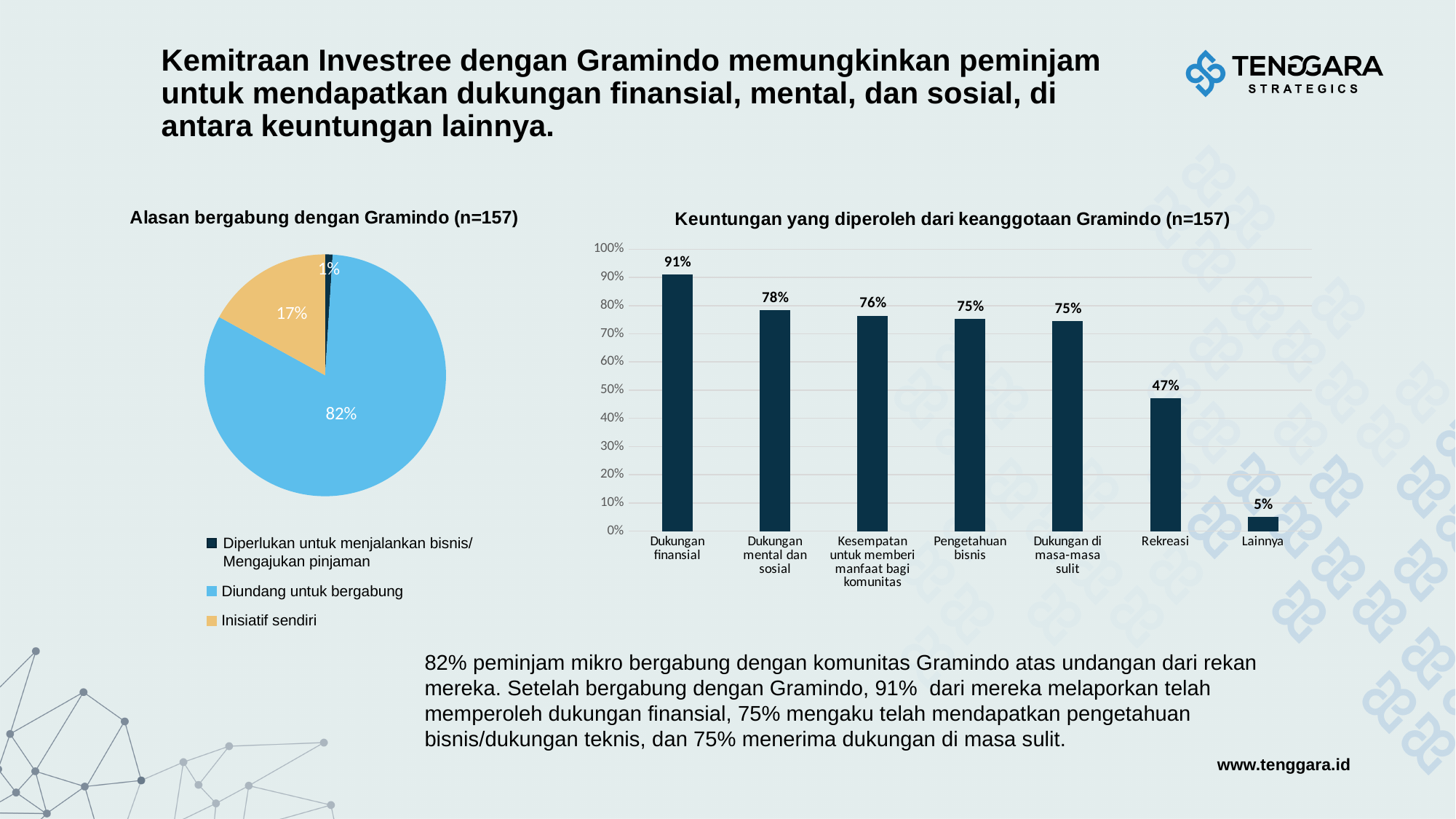
What kind of chart is 'Keuntungan yang diperoleh dari keanggotaan Gramindo (n=157)'? Bar chart In the pie chart 'Alasan bergabung dengan Gramindo (n=157)', which category has the smallest slice? Diperlukan untuk menjalankan bisnis/Mengajukan pinjaman In the bar chart 'Keuntungan yang diperoleh dari keanggotaan Gramindo (n=157)', which is larger: 'Kesempatan untuk memberi manfaat bagi komunitas' or 'Rekreasi'? Kesempatan untuk memberi manfaat bagi komunitas How many categories does the legend of the pie chart 'Alasan bergabung dengan Gramindo (n=157)' list? 3 In the bar chart 'Keuntungan yang diperoleh dari keanggotaan Gramindo (n=157)', do the values rise or fall from left to right? Fall In the bar chart 'Keuntungan yang diperoleh dari keanggotaan Gramindo (n=157)', what is the value for 'Dukungan finansial'? 91% In the bar chart 'Keuntungan yang diperoleh dari keanggotaan Gramindo (n=157)', which category has the lowest value? Lainnya In the pie chart 'Alasan bergabung dengan Gramindo (n=157)', what share is 'Inisiatif sendiri'? 17% How many categories are shown in the bar chart 'Keuntungan yang diperoleh dari keanggotaan Gramindo (n=157)'? 7 In the bar chart 'Keuntungan yang diperoleh dari keanggotaan Gramindo (n=157)', what is the difference between 'Dukungan finansial' and 'Dukungan mental dan sosial'? 13% In the bar chart 'Keuntungan yang diperoleh dari keanggotaan Gramindo (n=157)', what is the value for 'Rekreasi'? 47% In the pie chart 'Alasan bergabung dengan Gramindo (n=157)', what share is 'Diundang untuk bergabung'? 82%